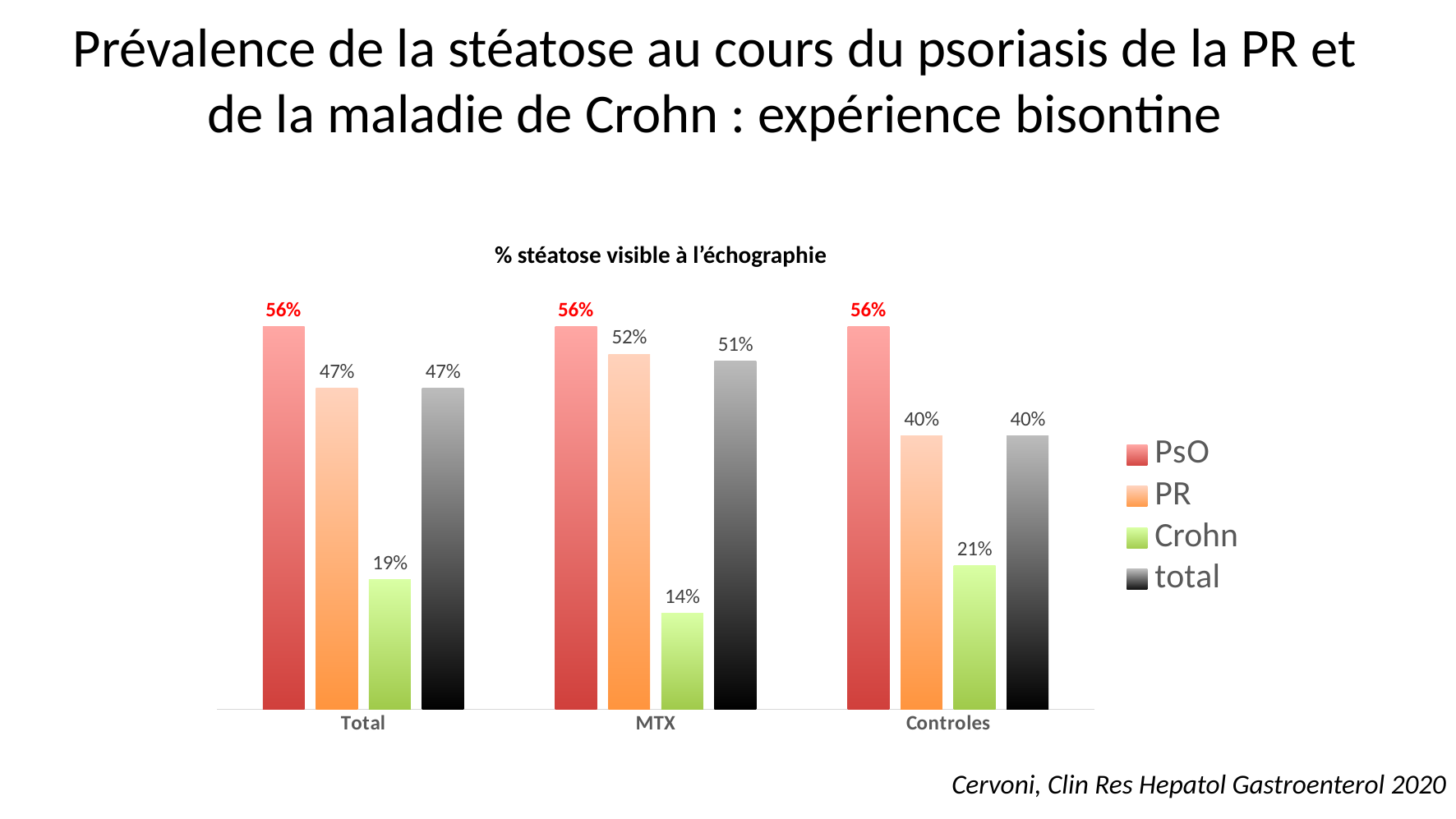
What is the title of the chart? % stéatose visible à l'échographie What is the value for Crohn in the Controles group? 21% Which is larger in the Total group: the PR value or the Crohn value? PR What is the value for total in the MTX group? 51% What is the difference between the PsO and PR values in the Controles group? 16% Which series has the highest value in the Controles group? PsO What kind of chart is shown? Bar chart How many series does the legend list? 4 What is the value for PsO in the Total group? 56% How many groups are shown on the x axis? 3 Which series has the lowest value in the MTX group? Crohn What is the value for PR in the MTX group? 52%